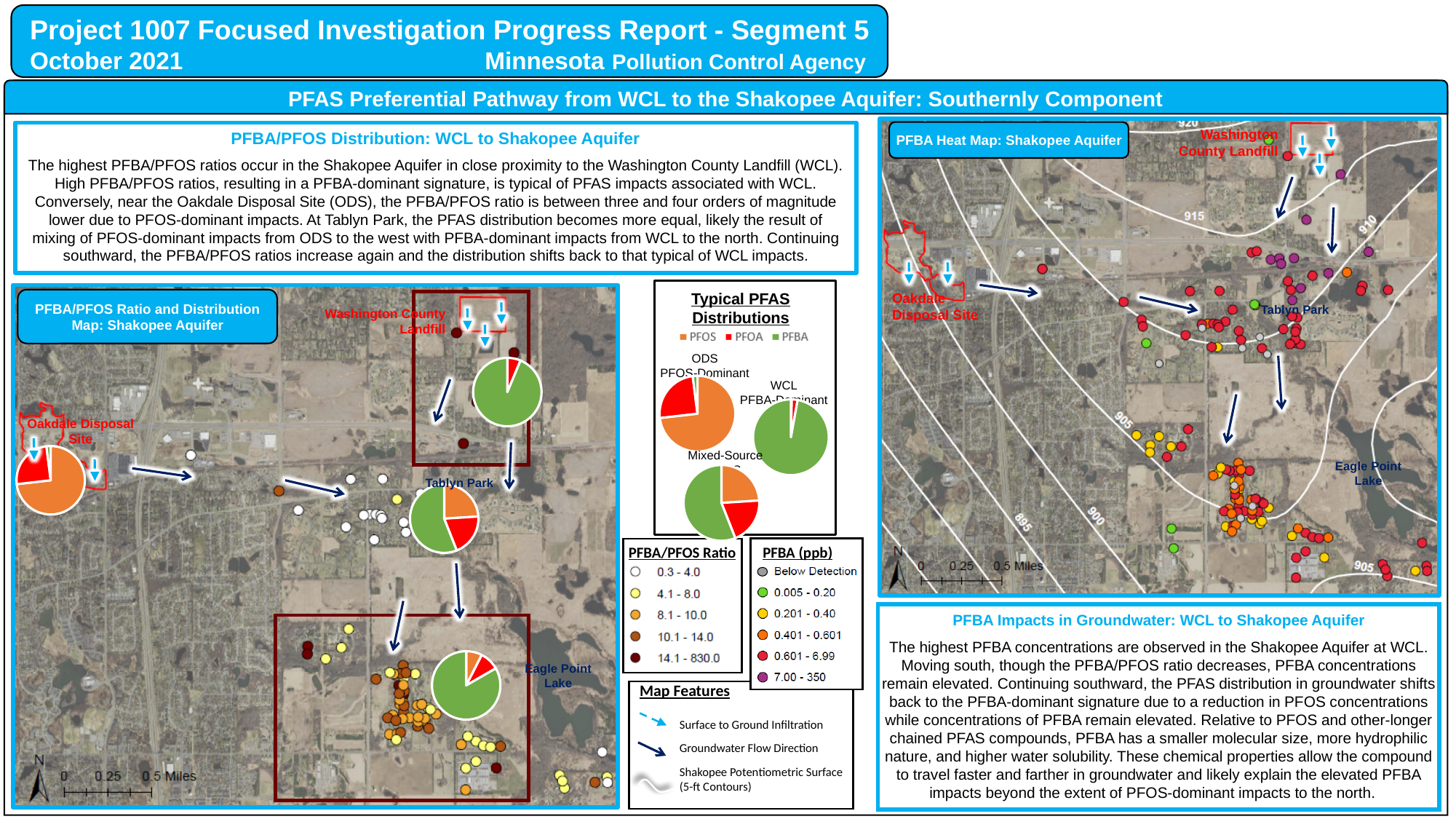
In the Mixed-Source pie of the 'Typical PFAS Distributions' panel, which slice is larger, PFBA or PFOA? PFBA What kind of chart is used in the 'Typical PFAS Distributions' panel? pie chart In the 'Typical PFAS Distributions' panel, which compound has the largest slice in the ODS PFOS-Dominant pie? PFOS How many pie charts are shown in the 'Typical PFAS Distributions' panel? 3 How many entries does the legend of the 'Typical PFAS Distributions' chart list? 3 In the 'Typical PFAS Distributions' panel, which compound has the largest slice in the Mixed-Source pie? PFBA On the 'PFBA/PFOS Ratio and Distribution Map', which compound has the largest slice in the pie at the Oakdale Disposal Site? PFOS In the ODS PFOS-Dominant pie of the 'Typical PFAS Distributions' panel, which slice is larger, PFOS or PFOA? PFOS In the 'Typical PFAS Distributions' panel, which compound has the smallest slice in the ODS PFOS-Dominant pie? PFBA In the 'Typical PFAS Distributions' legend, what colour represents PFBA? green What is the title of the pie chart panel in the middle of the slide? Typical PFAS Distributions